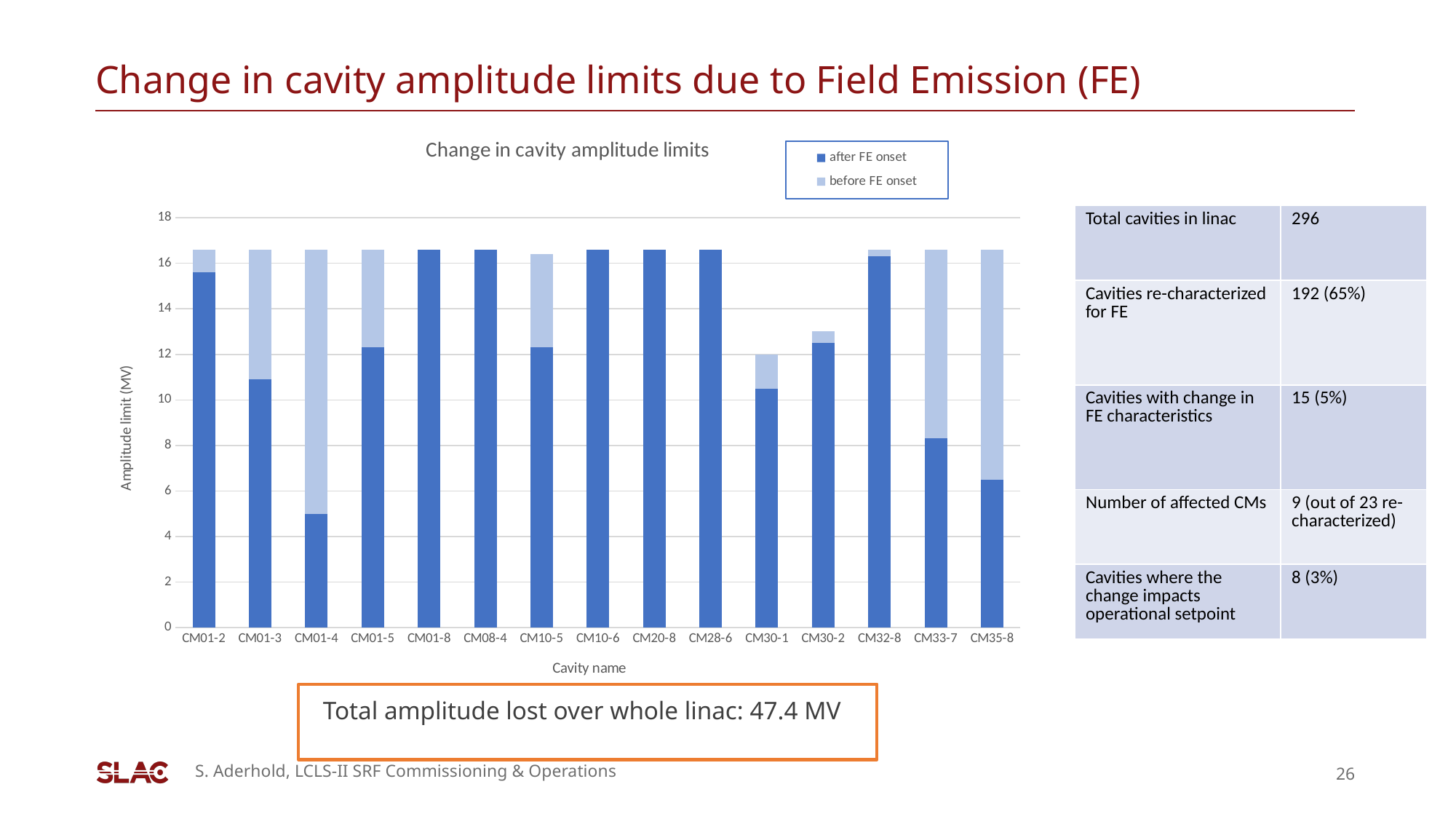
Which cavity has the lowest amplitude limit after FE onset? CM01-4 Is the after FE onset value for CM30-2 greater or less than 12? greater How many series does the chart legend list? 2 Which has the larger after FE onset value, CM01-3 or CM01-5? CM01-5 What is the label of the vertical axis of the chart? Amplitude limit (MV) What is the title of the chart? Change in cavity amplitude limits How many cavities are shown on the x axis of the chart? 15 Is the after FE onset value for CM01-2 greater or less than 16? less Is the after FE onset value for CM35-8 greater or less than 8? less Which has the larger after FE onset value, CM33-7 or CM35-8? CM33-7 What kind of chart is shown on the slide? bar chart